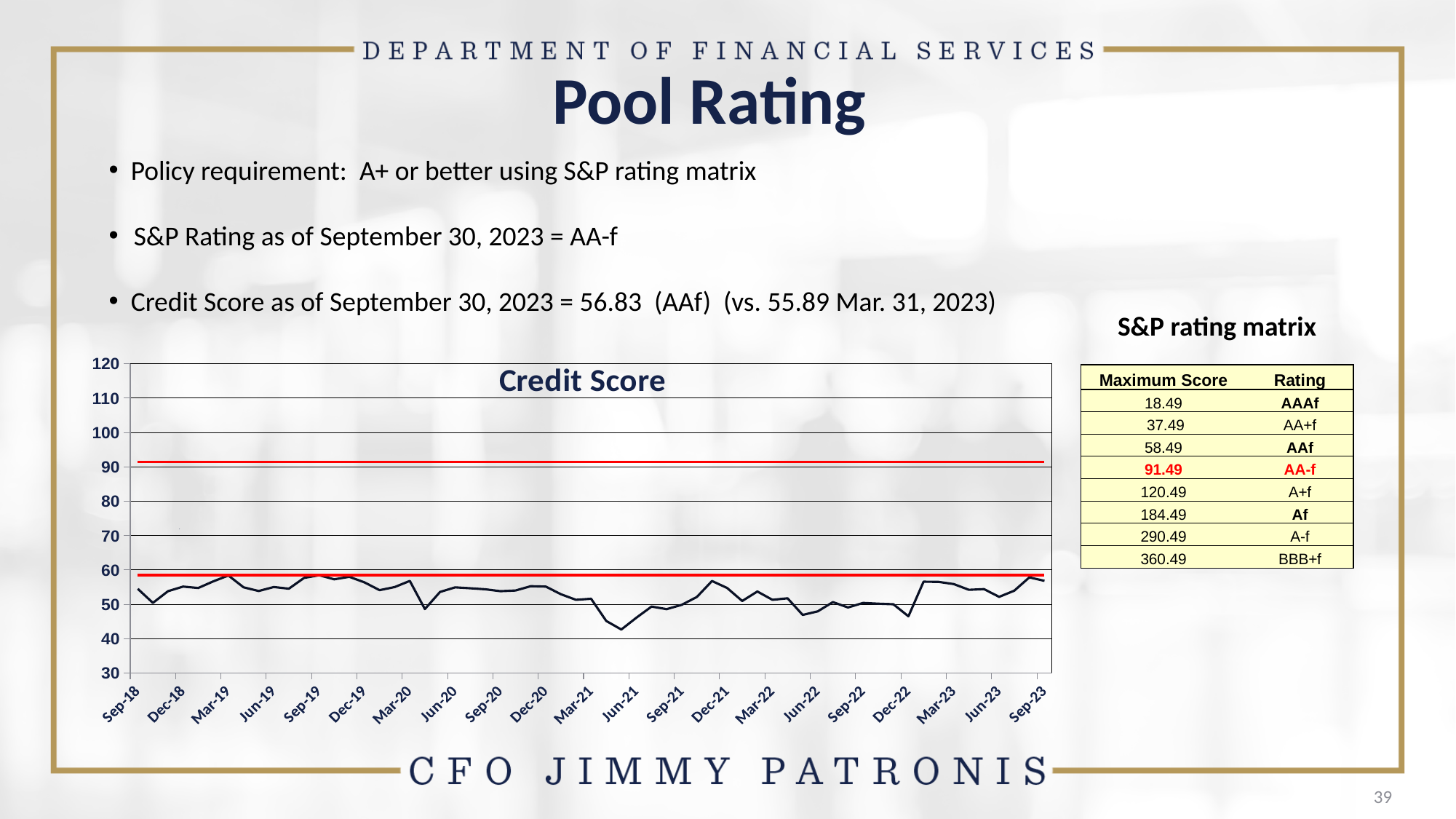
On the Credit Score chart, which is larger, the value for Jun-22 or the value for Sep-19? Sep-19 What kind of chart is the Credit Score chart? line chart Is the value for Jun-21 on the Credit Score chart greater or less than 50? less On the Credit Score chart, which is larger, the value for Jun-21 or the value for Dec-21? Dec-21 Is the value for Jun-22 on the Credit Score chart greater or less than 50? less On the Credit Score chart, does the line rise or fall between Mar-21 and Jun-21? fall Is the value for Dec-21 on the Credit Score chart greater or less than 50? greater How many date labels are shown on the x axis of the Credit Score chart? 21 What is the title of the chart on the slide? Credit Score What are the lowest and highest values shown on the y axis of the Credit Score chart? 30 and 120